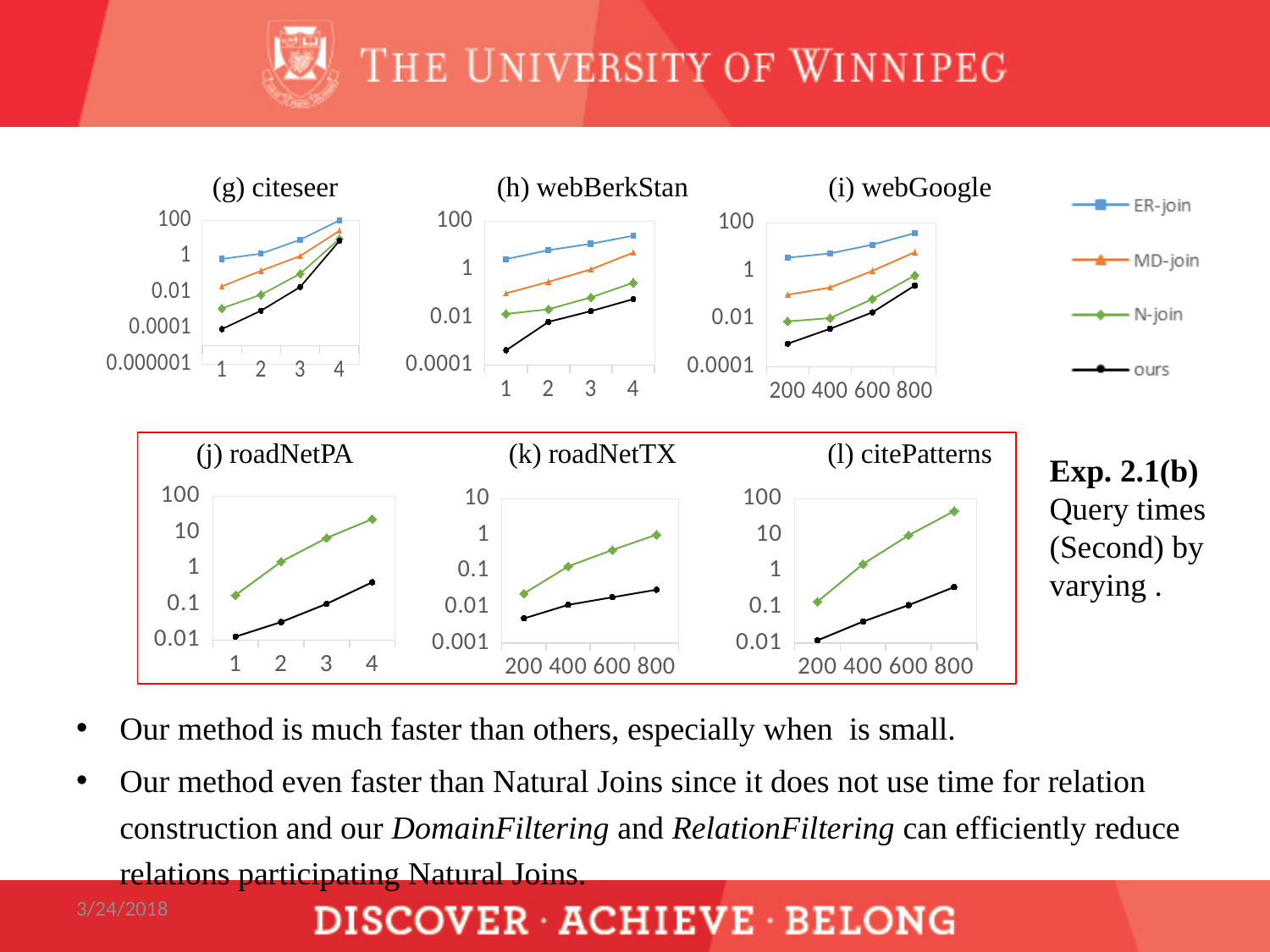
How many series does the legend on the right list? 4 In the (h) webBerkStan chart, which series has the lowest values across all x-axis points? ours In the (h) webBerkStan chart, is the value for ER-join at x = 4 greater or less than 1? greater In the (l) citePatterns chart, do the values for N-join rise or fall as the x-axis increases from 200 to 800? rise In the (i) webGoogle chart, which is larger at x = 800: ER-join or ours? ER-join What kind of chart is (g) citeseer? line chart In the (j) roadNetPA chart, is the value for N-join at x = 4 greater or less than 10? greater In the (g) citeseer chart, which series has the highest values across all x-axis points? ER-join How many x-axis points are plotted in the (j) roadNetPA chart? 4 In the (k) roadNetTX chart, is the value for ours at x = 200 greater or less than 0.01? less According to the legend, which series is drawn in black? ours